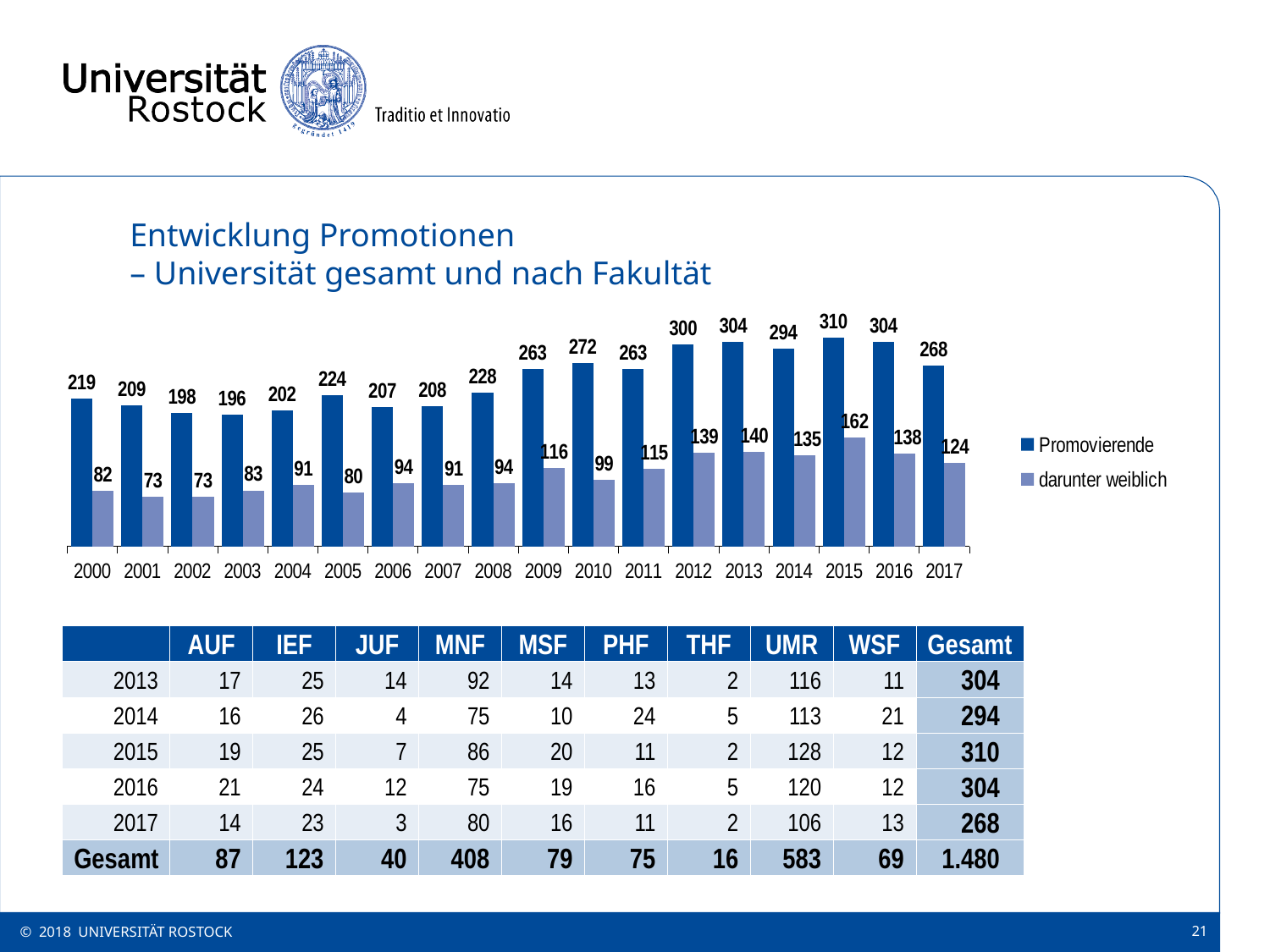
Which is larger, the Promovierende value in 2010 or in 2011? 2010 What is the value for Promovierende in 2000? 219 What is the value for darunter weiblich in 2012? 139 What kind of chart is shown on the slide? Bar chart How many years are shown on the x axis of the chart? 18 In which year is the darunter weiblich value highest? 2015 In which year is the Promovierende value lowest? 2003 What is the difference between Promovierende and darunter weiblich in 2015? 148 By how much did the Promovierende value fall from 2016 to 2017? 36 What is the value for Promovierende in 2017? 268 How many series does the chart legend list? 2 In which year is the Promovierende value highest? 2015